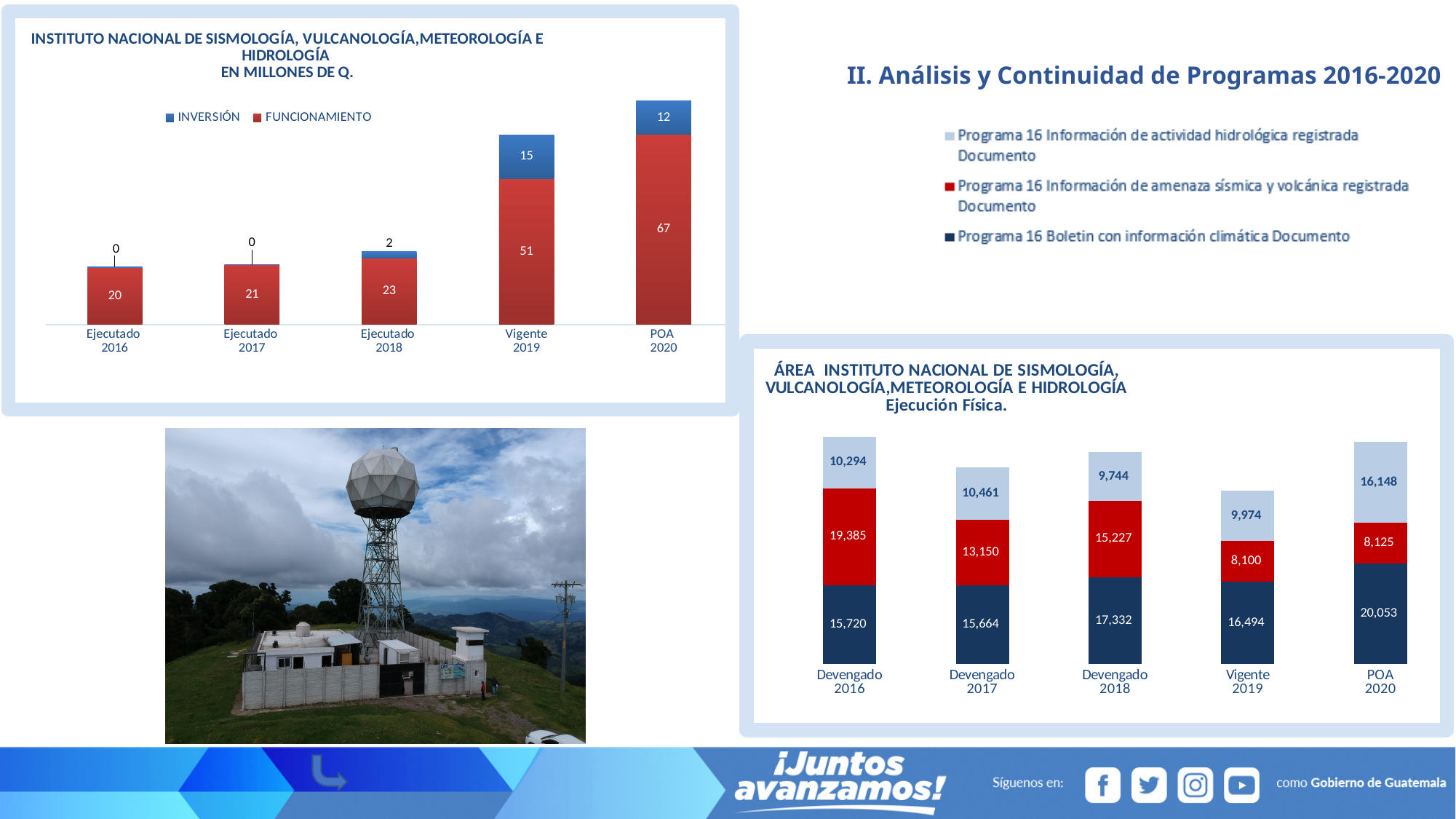
In the chart titled 'EN MILLONES DE Q.', how many series does the legend list? 2 In the chart titled 'Ejecución Física.', what is the total of the stacked bar for Devengado 2016? 45,399 In the chart titled 'EN MILLONES DE Q.', what is the difference between the FUNCIONAMIENTO values for Vigente 2019 and Ejecutado 2018? 28 In the chart titled 'EN MILLONES DE Q.', which category has the highest FUNCIONAMIENTO value? POA 2020 What kind of chart is the chart titled 'Ejecución Física.'? Stacked bar chart In the chart titled 'Ejecución Física.', what is the value for 'Programa 16 Boletin con información climática Documento' for POA 2020? 20,053 In the chart titled 'Ejecución Física.', which category has the lowest value for 'Programa 16 Información de amenaza sísmica y volcánica registrada Documento'? Vigente 2019 In the chart titled 'EN MILLONES DE Q.', what is the INVERSIÓN value for POA 2020? 12 In the chart titled 'EN MILLONES DE Q.', what is the FUNCIONAMIENTO value for Vigente 2019? 51 In the chart titled 'Ejecución Física.', how many categories are shown on the x axis? 5 In the chart titled 'Ejecución Física.', what is the value for 'Programa 16 Información de amenaza sísmica y volcánica registrada Documento' for Devengado 2017? 13,150 In the chart titled 'EN MILLONES DE Q.', what is the total of the stacked bar for POA 2020? 79